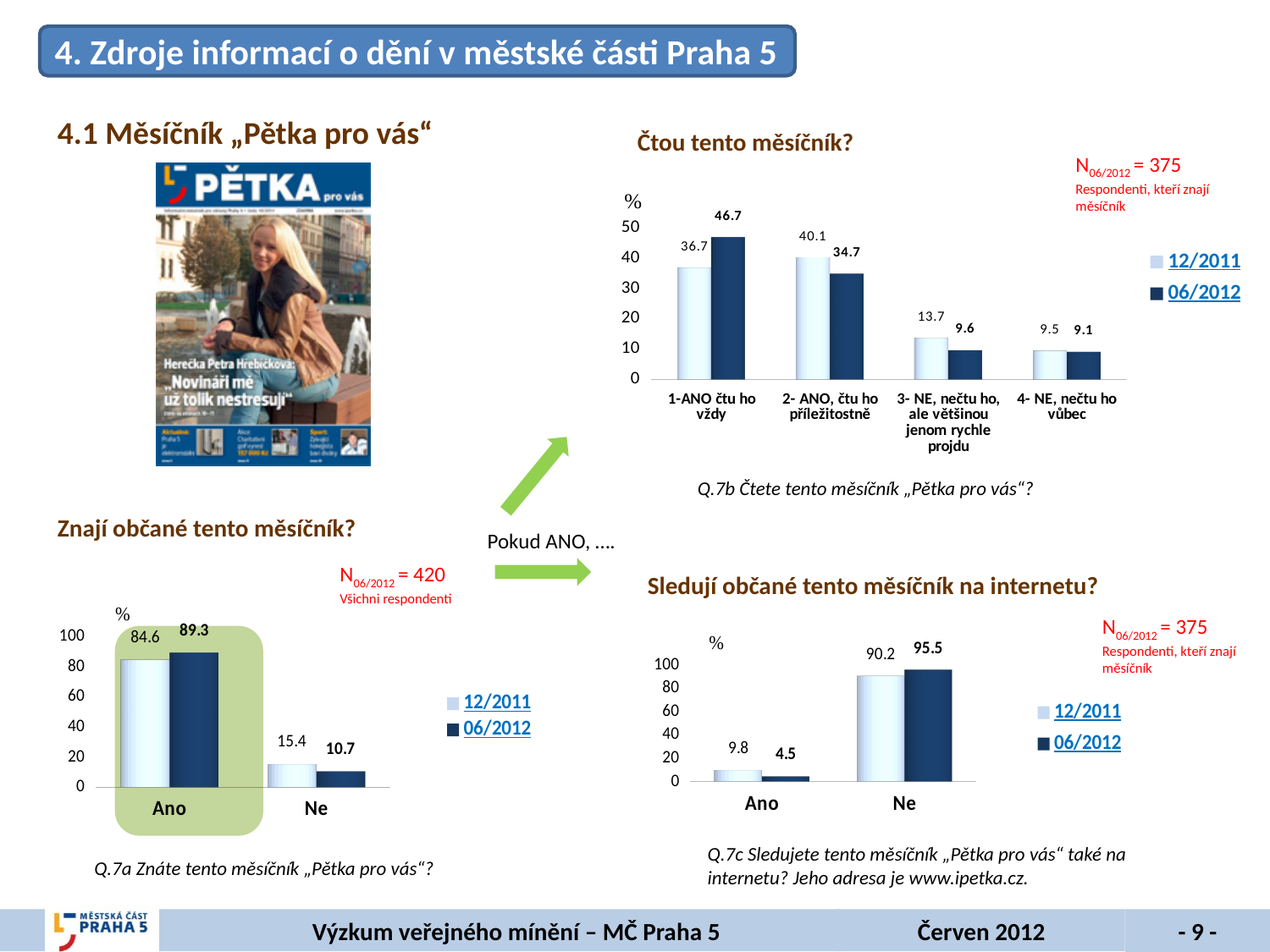
In the chart "Čtou tento měsíčník?", what is the difference between the 06/2012 and 12/2011 values for "1-ANO čtu ho vždy"? 10 In the chart "Znají občané tento měsíčník?", what is the 06/2012 value for "Ano"? 89.3 What kind of chart is "Sledují občané tento měsíčník na internetu?"? bar chart In the chart "Znají občané tento měsíčník?", how many series does the legend list? 2 In the chart "Čtou tento měsíčník?", is the 12/2011 value for "3- NE, nečtu ho, ale většinou jenom rychle projdu" greater or less than 20? less In the chart "Čtou tento měsíčník?", how many categories are shown on the x axis? 4 In the chart "Čtou tento měsíčník?", what is the 12/2011 value for "2- ANO, čtu ho příležitostně"? 40.1 In the chart "Znají občané tento měsíčník?", what is the difference between the 12/2011 and 06/2012 values for "Ne"? 4.7 In the chart "Čtou tento měsíčník?", which category has the lowest 06/2012 value? 4- NE, nečtu ho vůbec In the chart "Sledují občané tento měsíčník na internetu?", what is the 12/2011 value for "Ano"? 9.8 In the chart "Čtou tento měsíčník?", what is the 06/2012 value for "1-ANO čtu ho vždy"? 46.7 In the chart "Sledují občané tento měsíčník na internetu?", which is larger for "Ne": the 12/2011 value or the 06/2012 value? 06/2012